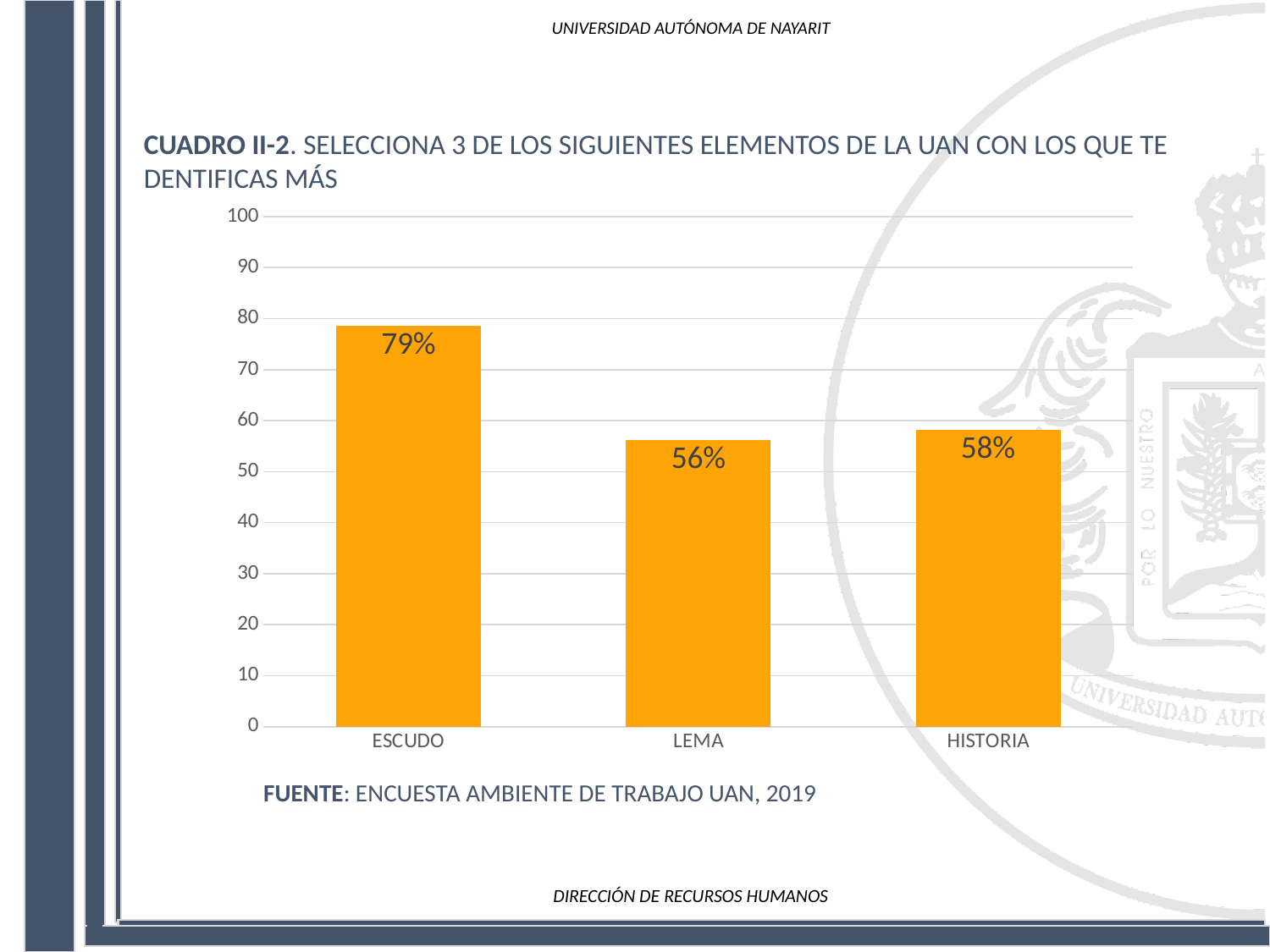
What is the value for ESCUDO? 79% What is the value for LEMA? 56% Is the value for LEMA greater or less than 60? less What is the value for HISTORIA? 58% What is the difference between the values for HISTORIA and LEMA? 2% Which category has the highest value? ESCUDO Which category has the lowest value? LEMA What source is cited below the chart? ENCUESTA AMBIENTE DE TRABAJO UAN, 2019 How many categories are shown on the x axis? 3 What is the difference between the values for ESCUDO and LEMA? 23% Which is larger, the value for ESCUDO or the value for HISTORIA? ESCUDO What kind of chart is shown on the slide? bar chart